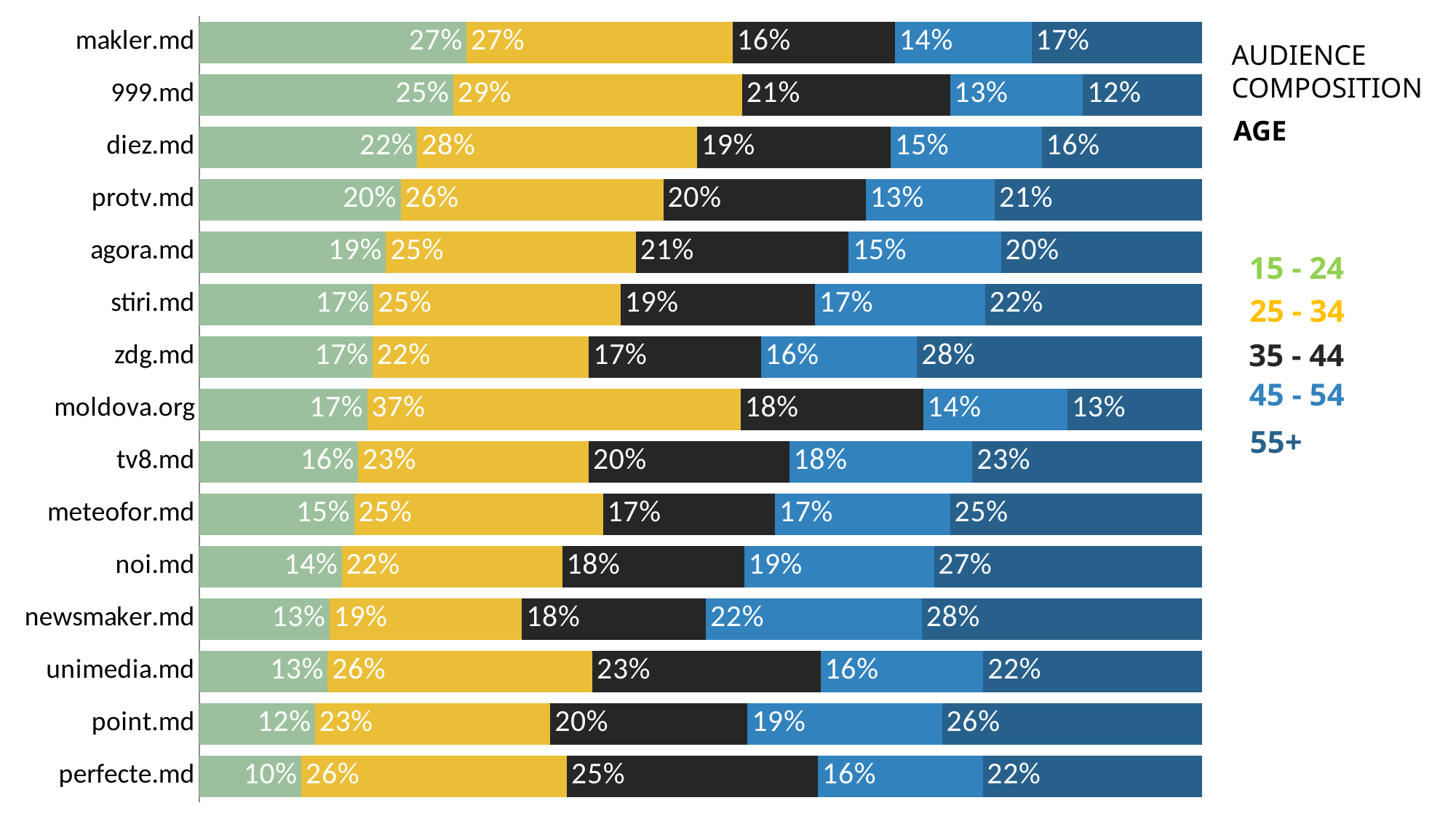
Which is larger: the 45 - 54 share for newsmaker.md or for 999.md? newsmaker.md How many websites are shown in the chart? 15 What percentage of makler.md's audience is aged 15 - 24? 27% What type of chart is shown on the slide? Stacked bar chart What share of moldova.org's audience falls in the 25 - 34 age group? 37% Which website has the highest 25 - 34 share? moldova.org What is the 35 - 44 value for perfecte.md? 25% How many age groups does the legend list? 5 Which website has the lowest share of 15 - 24 audience? perfecte.md What is the 55+ value for newsmaker.md? 28% What is the difference between the 55+ share of zdg.md and that of moldova.org? 15% Which website has the highest share of 15 - 24 audience? makler.md